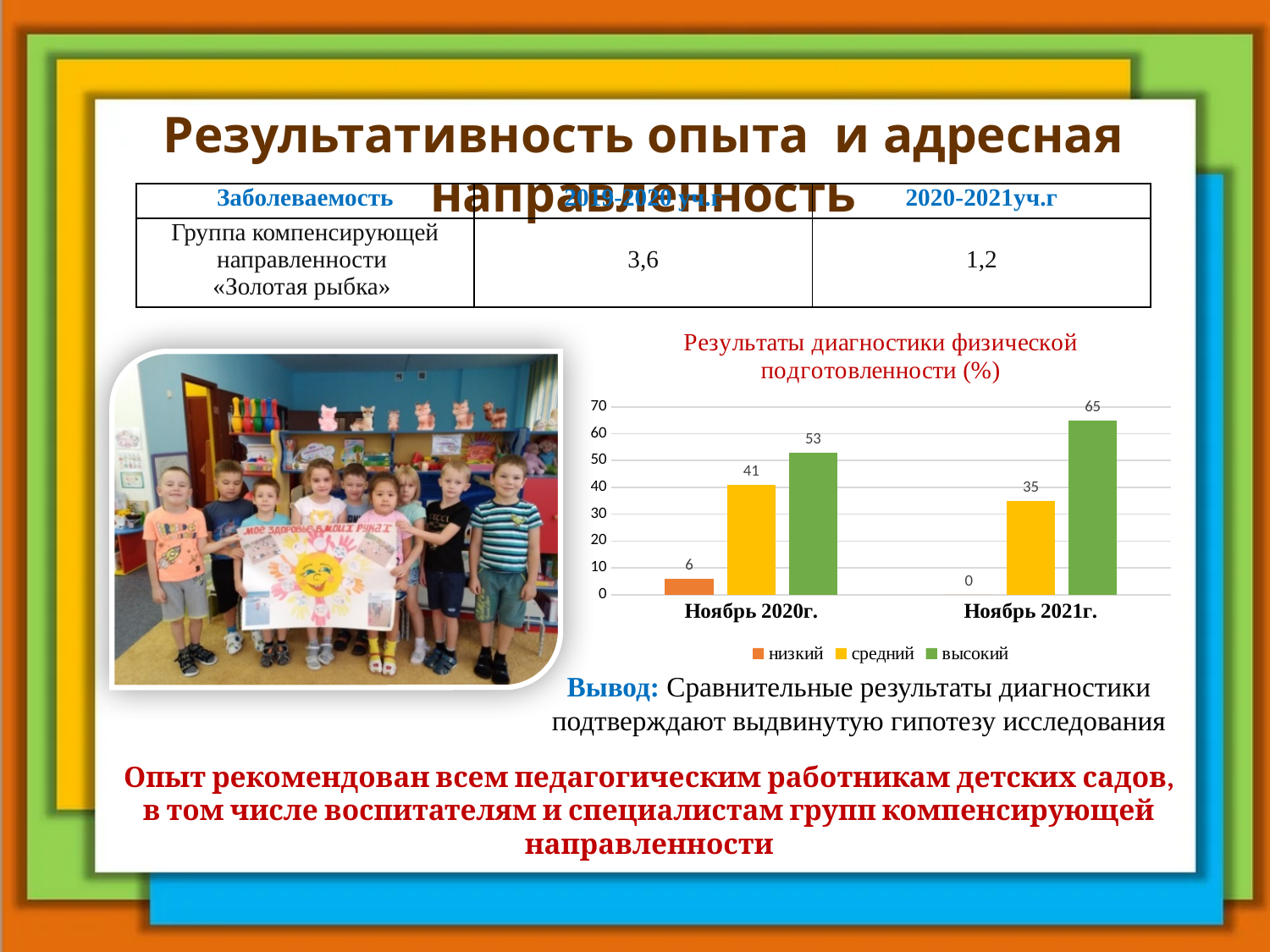
What is the value for "низкий" in Ноябрь 2020г.? 6 What is the title of the chart? Результаты диагностики физической подготовленности (%) Which series has the lowest value in Ноябрь 2020г.? низкий What is the value for "низкий" in Ноябрь 2021г.? 0 What type of chart is shown on the slide? bar chart How many categories are shown on the x axis? 2 What is the value for "средний" in Ноябрь 2021г.? 35 What is the difference between the "высокий" values for Ноябрь 2021г. and Ноябрь 2020г.? 12 Which is larger: "средний" in Ноябрь 2020г. or "средний" in Ноябрь 2021г.? Ноябрь 2020г. Which series has the highest value in Ноябрь 2021г.? высокий What is the value for "высокий" in Ноябрь 2020г.? 53 How many series does the legend list? 3